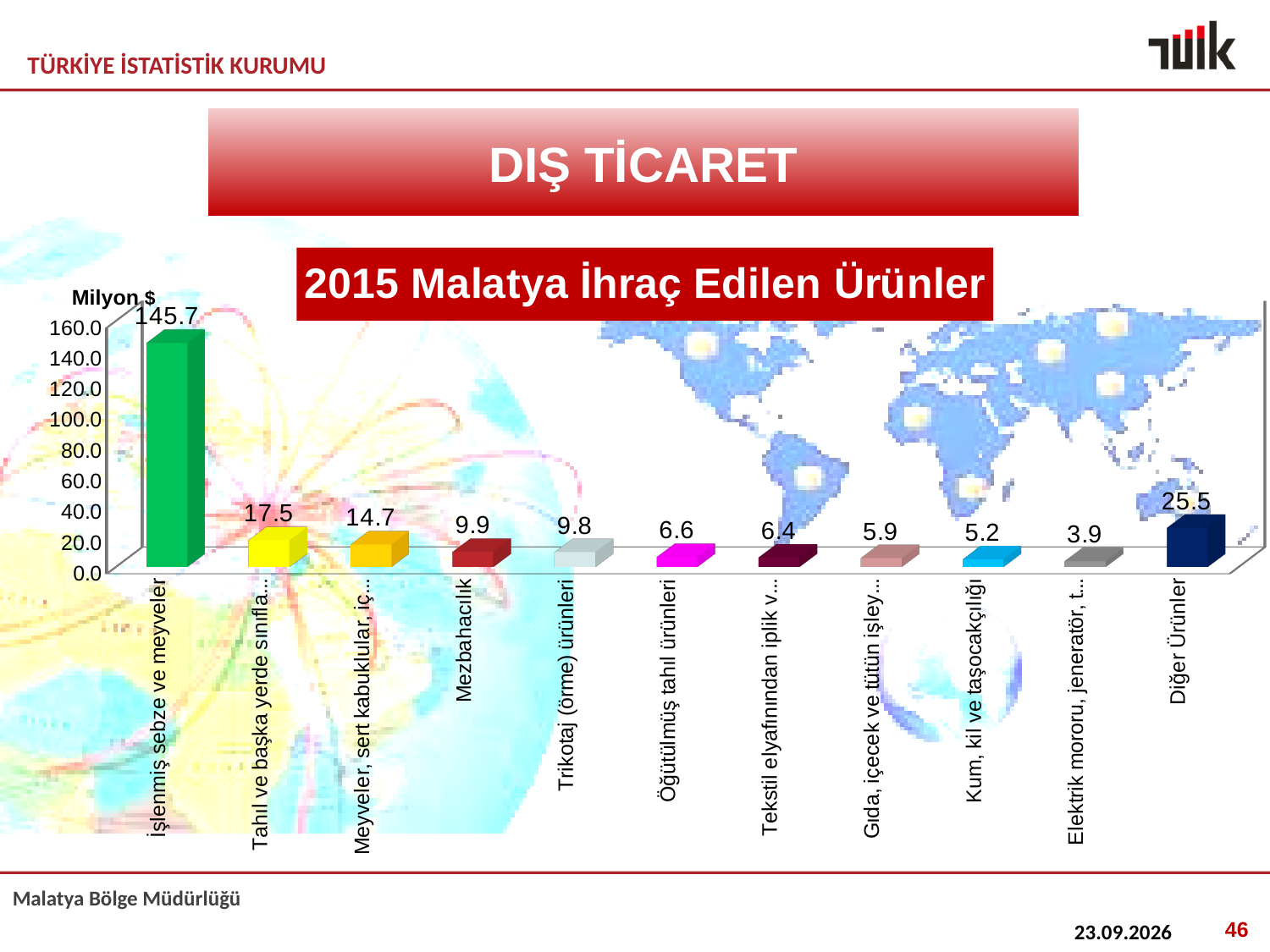
What is the value for Kum, kil ve taşocakçılığı? 5.2 What is the value for Mezbahacılık? 9.9 How many categories are shown in the chart? 11 What is the value for Diğer Ürünler? 25.5 What is the difference between the values for İşlenmiş sebze ve meyveler and Diğer Ürünler? 120.2 What kind of chart is shown on the slide? Bar chart What is the value for İşlenmiş sebze ve meyveler? 145.7 Which category has the highest value? İşlenmiş sebze ve meyveler Which is larger, the value for Mezbahacılık or the value for Öğütülmüş tahıl ürünleri? Mezbahacılık Which category has the lowest value? Elektrik mororu, jeneratör, t... Is the value for İşlenmiş sebze ve meyveler greater or less than 140.0? greater What unit is shown on the y axis of the chart? Milyon $